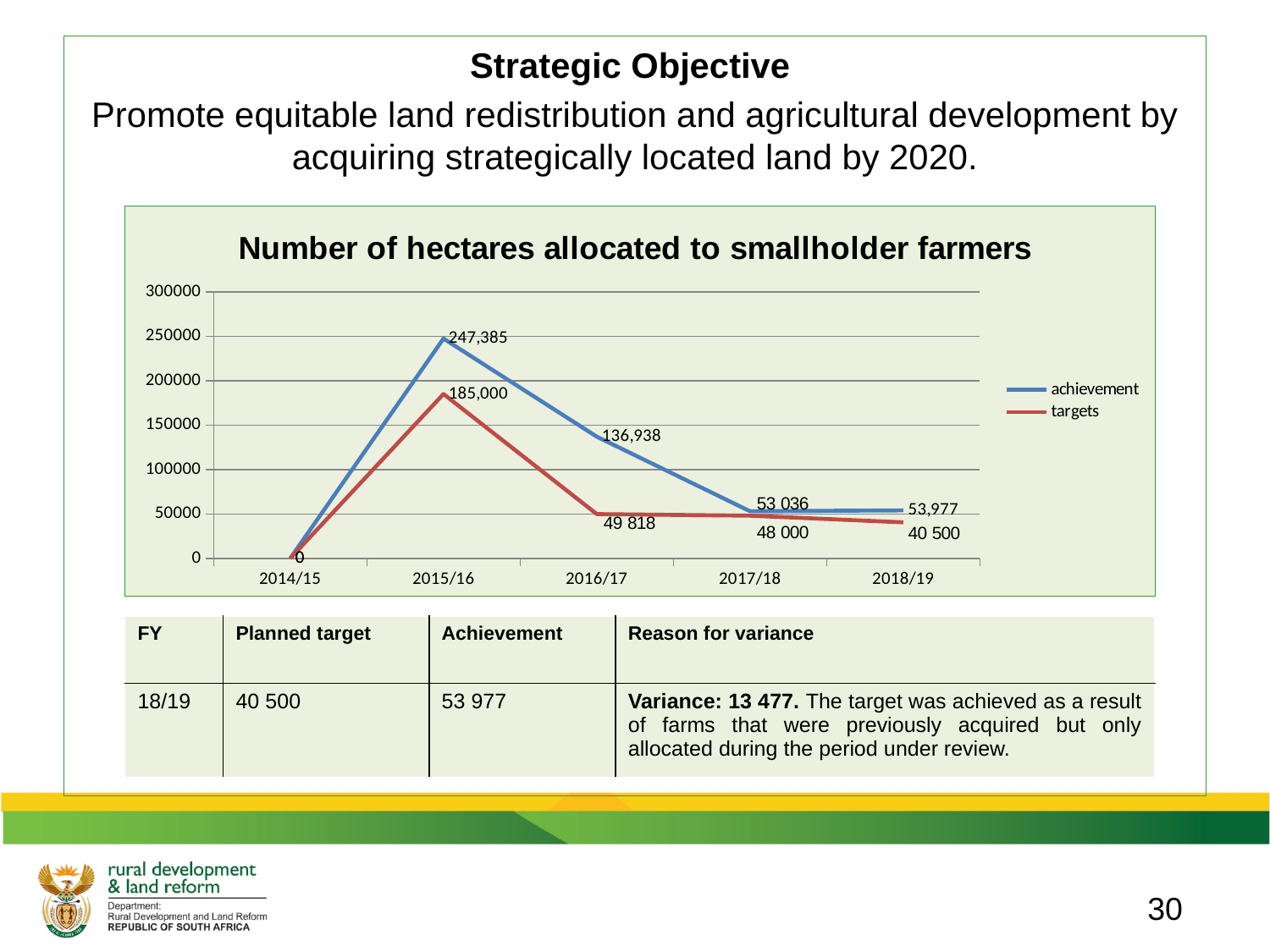
What is the targets value for 2018/19? 40 500 What is the achievement value for 2015/16? 247,385 In 2017/18, which is larger: the achievement or the target? achievement What kind of chart is shown on the slide? line chart What is the targets value for 2015/16? 185,000 How many financial years are plotted along the x axis of the chart? 5 By how much does the achievement exceed the target in 2018/19? 13 477 Does the achievement line rise or fall from 2015/16 to 2017/18? fall What is the difference between the achievement and the target in 2015/16? 62,385 What is the achievement value for 2016/17? 136,938 In which financial year is the achievement value highest? 2015/16 How many series does the legend of the chart list? 2